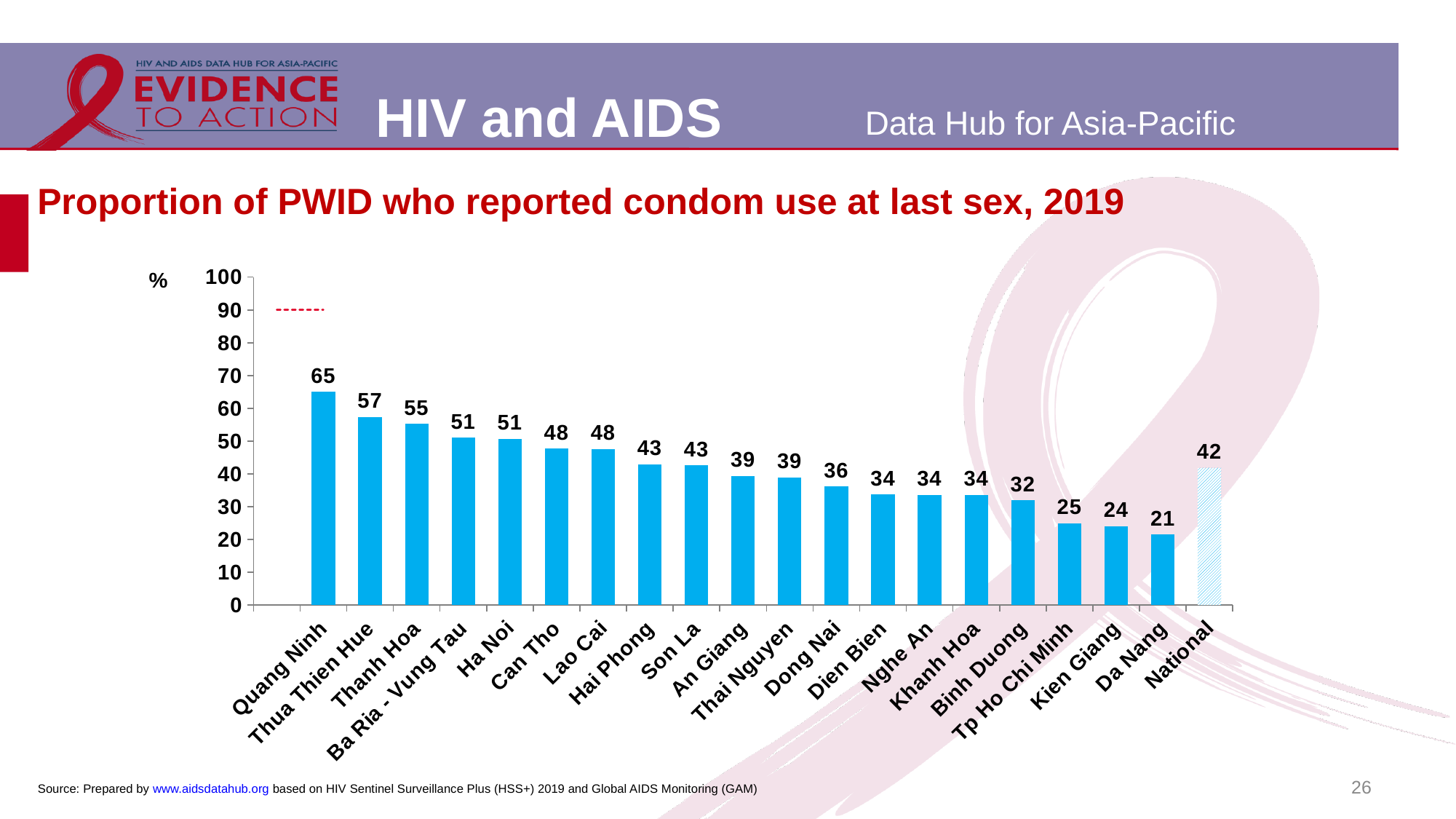
What is the value for Quang Ninh? 65 What kind of chart is shown on the slide? bar chart What is the difference between the National value and the value for Dong Nai? 6 What is the value for Hai Phong? 43 What is the difference between the values for Quang Ninh and Da Nang? 44 Which province has the lowest proportion of PWID who reported condom use at last sex? Da Nang What is the National value shown on the chart? 42 Which province has the highest proportion of PWID who reported condom use at last sex? Quang Ninh How many bars are plotted on the chart, including National? 20 Which is larger, the value for Ha Noi or the value for Tp Ho Chi Minh? Ha Noi Is the value for Thanh Hoa greater or less than 50? greater Do the province values rise or fall from left to right along the x axis (excluding the National bar)? fall